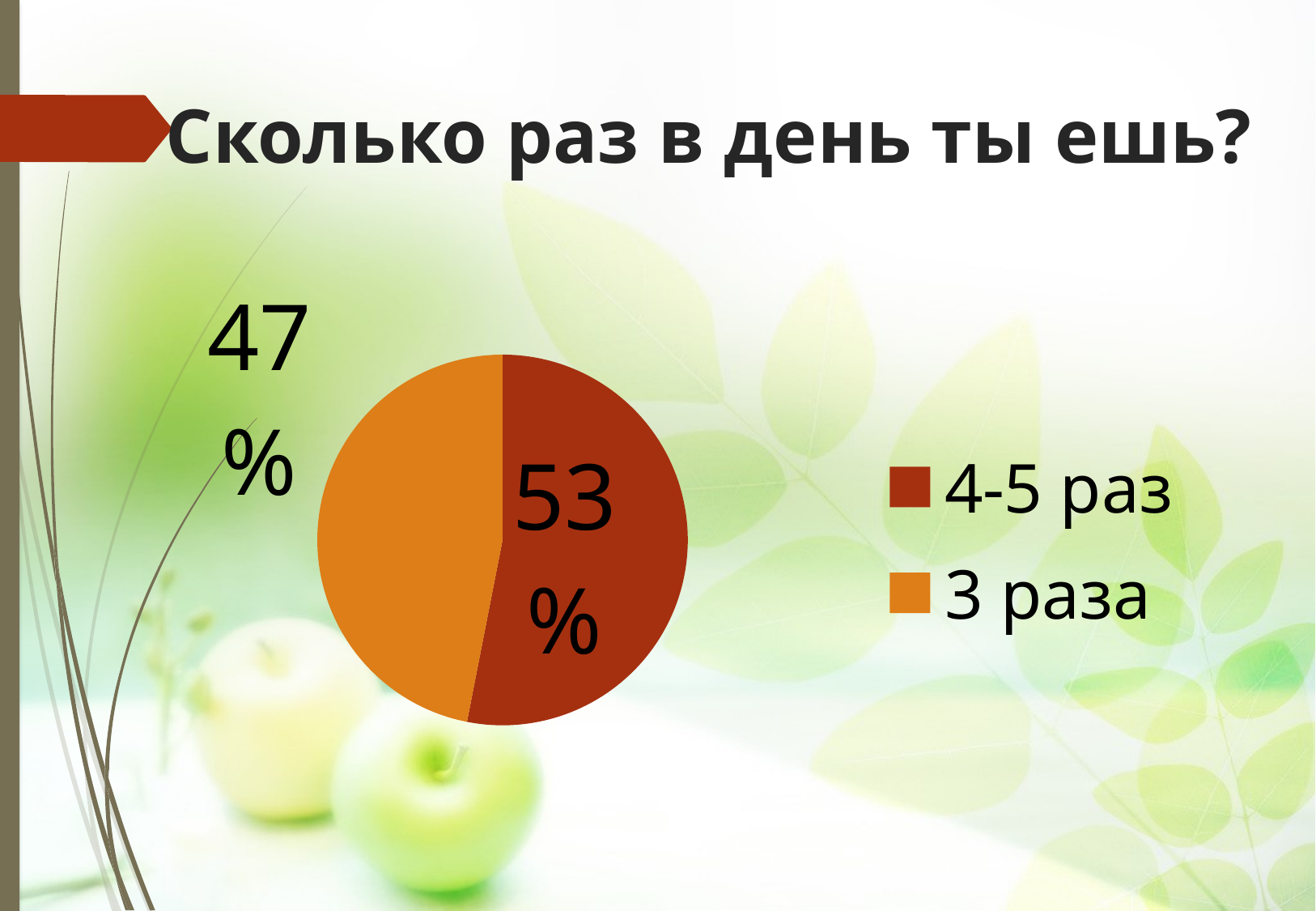
What is the total of the two slice percentages shown? 100% What is the title of the slide containing the chart? Сколько раз в день ты ешь? How many slices does the pie chart have? 2 What kind of chart is shown on the slide? pie chart What colour is the "3 раза" slice? orange What percentage of respondents eat 3 times a day ("3 раза")? 47% What is the difference in percentage points between the "4-5 раз" and "3 раза" slices? 6 Which category has the smallest share of the pie? 3 раза Which slice is larger: "4-5 раз" or "3 раза"? 4-5 раз How many entries does the legend list? 2 What percentage of respondents eat 4-5 times a day ("4-5 раз")? 53% Which category has the largest share of the pie? 4-5 раз